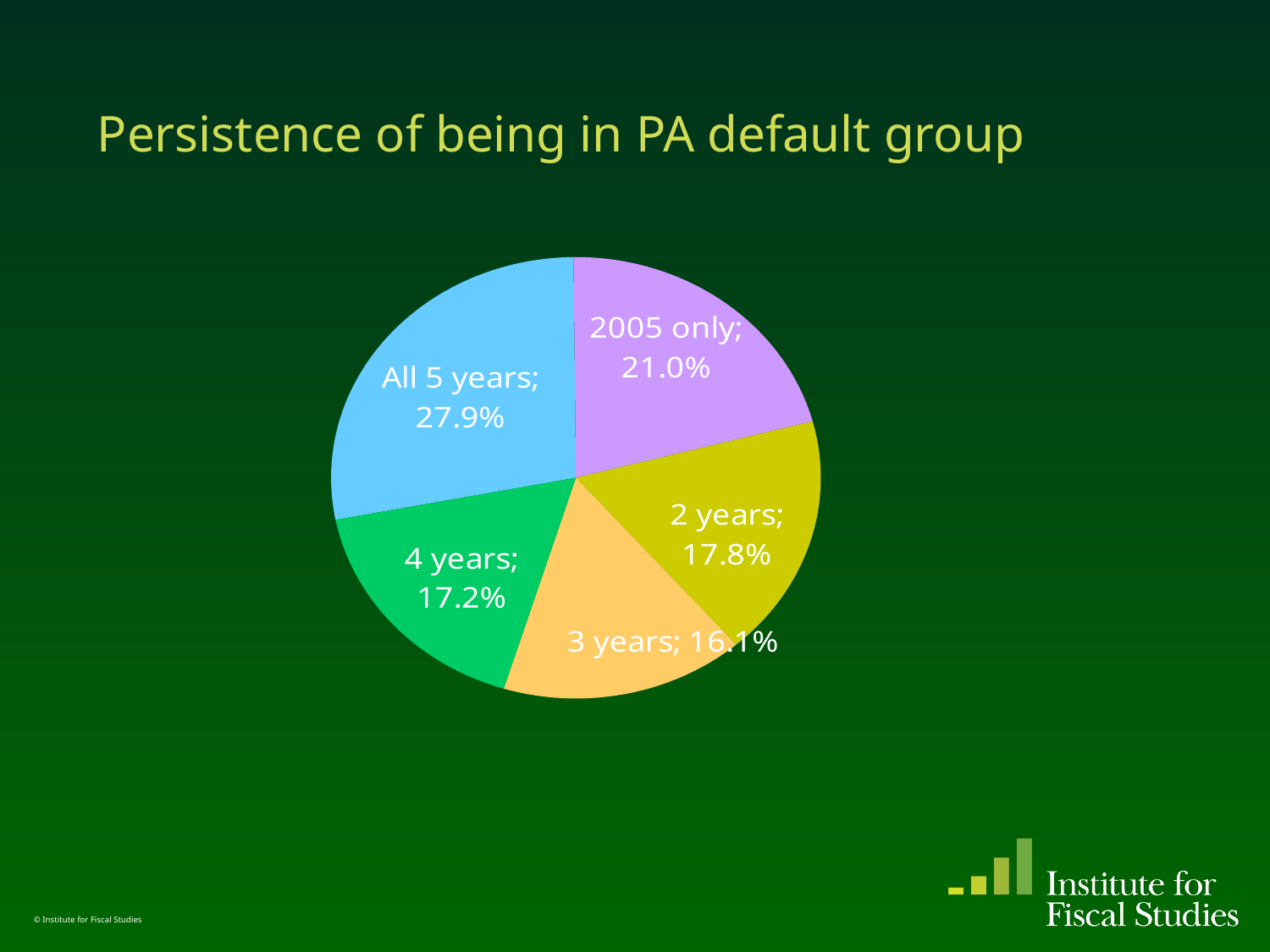
How many slices does the pie chart have? 5 What is the title of the chart? Persistence of being in PA default group Which is larger, the share for "2005 only" or the share for "4 years"? 2005 only What kind of chart is shown on the slide? pie chart What is the difference in percentage points between "All 5 years" and "2005 only"? 6.9 percentage points What is the share for "4 years"? 17.2% Which category has the largest slice of the pie? All 5 years What is the share for "2005 only"? 21.0% What is the share for "All 5 years"? 27.9% Which category has the smallest slice of the pie? 3 years What is the share for "2 years"? 17.8% What is the share for "3 years"? 16.1%